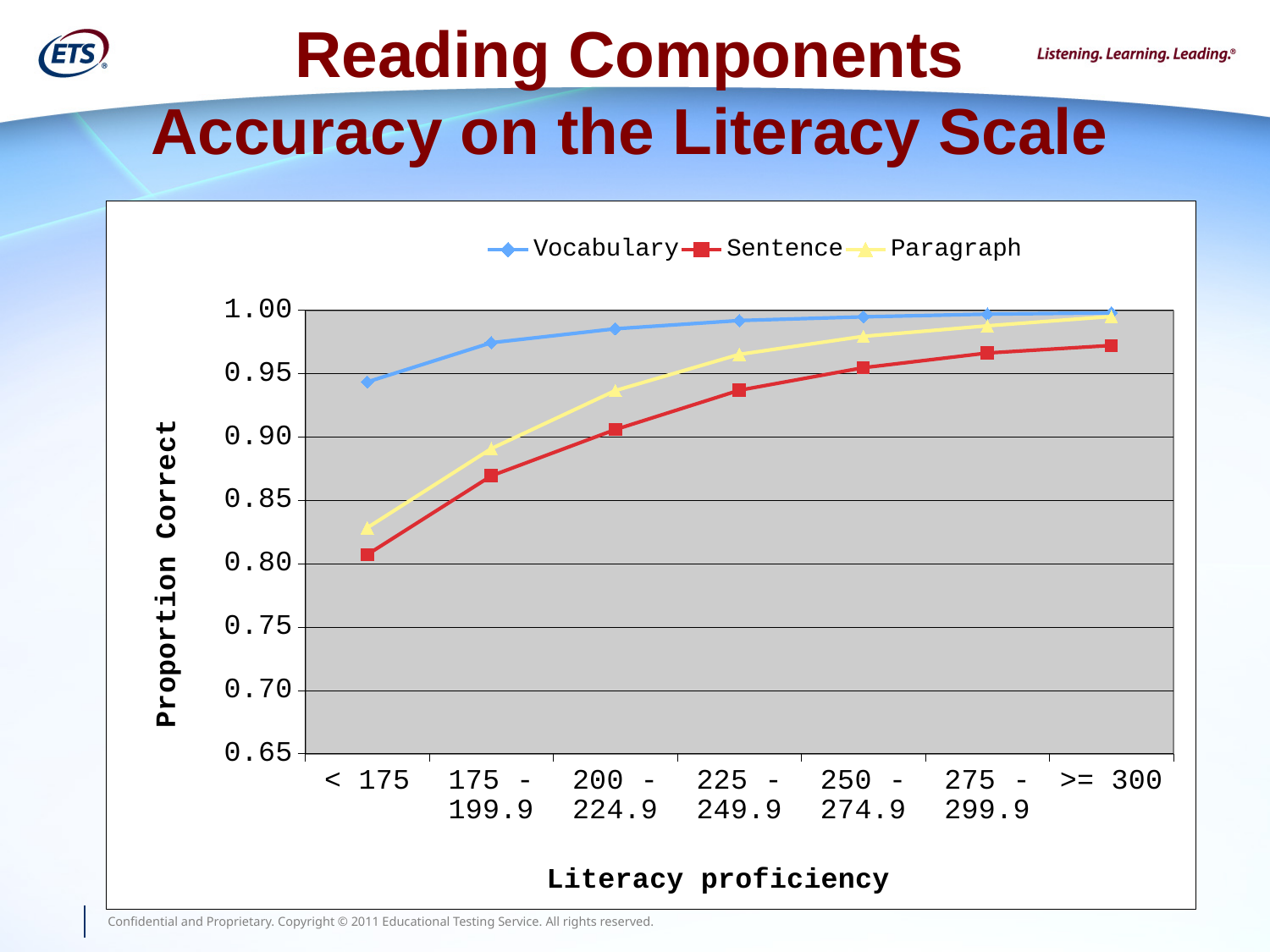
How many series does the legend list? 3 In the 175 - 199.9 category, which is larger, the Paragraph value or the Sentence value? Paragraph What is the title of the y axis? Proportion Correct What kind of chart is shown on the slide? line chart Is the Paragraph value for 200 - 224.9 greater or less than 0.90? greater Which series has the lowest value in the < 175 category? Sentence How many literacy proficiency categories are shown on the x axis? 7 Which series has the highest value in the < 175 category? Vocabulary Is the Vocabulary value for < 175 greater or less than 0.90? greater In which literacy proficiency category is the Sentence value lowest? < 175 Is the Sentence value for < 175 greater or less than 0.85? less Do the Sentence values rise or fall as literacy proficiency increases along the x axis? rise